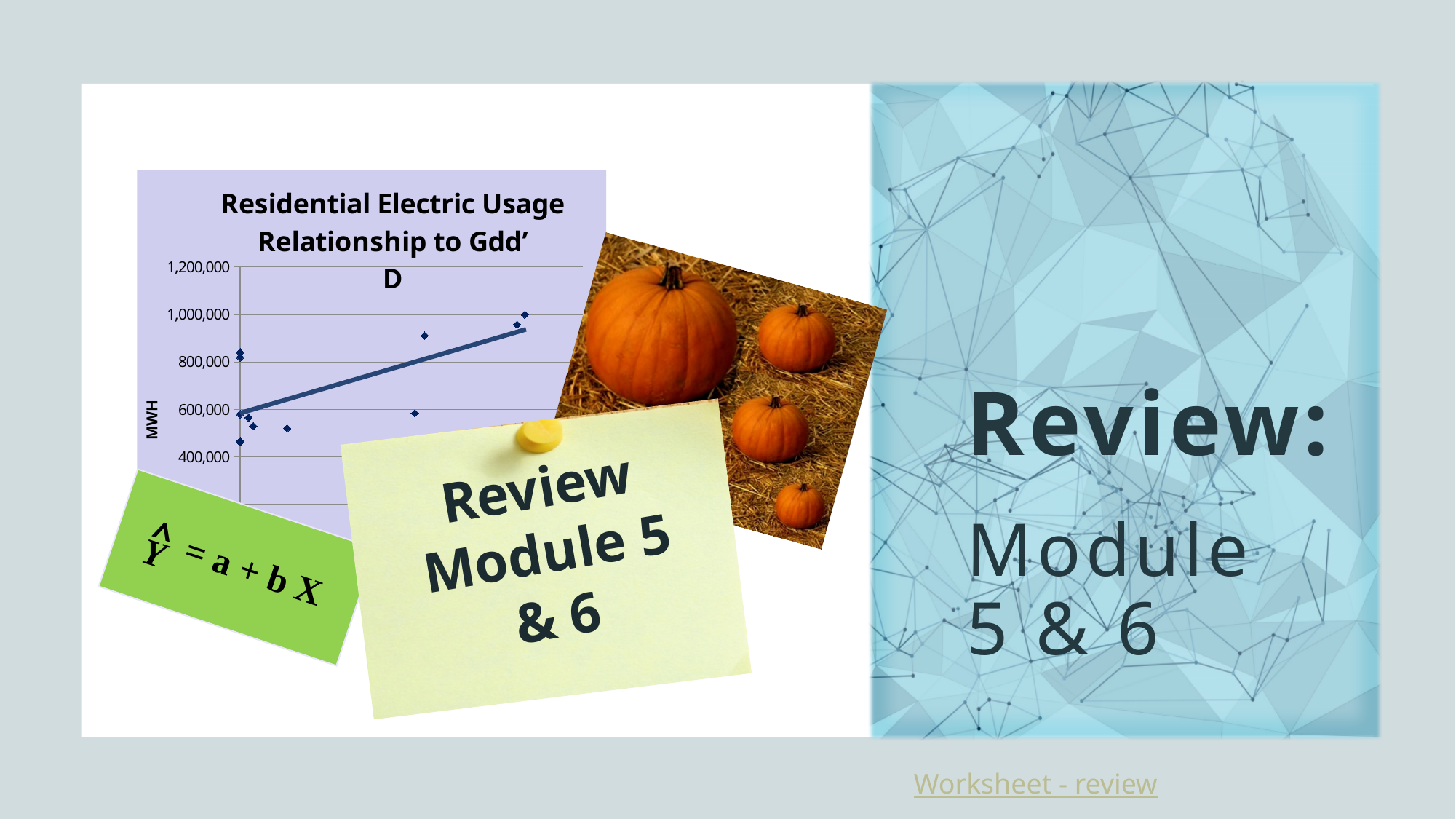
Does the trend line in the chart rise or fall from left to right? rise What kind of chart is shown on the slide? scatter chart Is the value of the lowest plotted point in the chart greater or less than 600,000? less Is the value of the highest plotted point in the chart greater or less than 1,200,000? less Is the value of the lowest plotted point in the chart greater or less than 400,000? greater What is the label on the vertical axis of the chart? MWH What is the title of the chart on the slide? Residential Electric Usage Relationship to Gdd' D